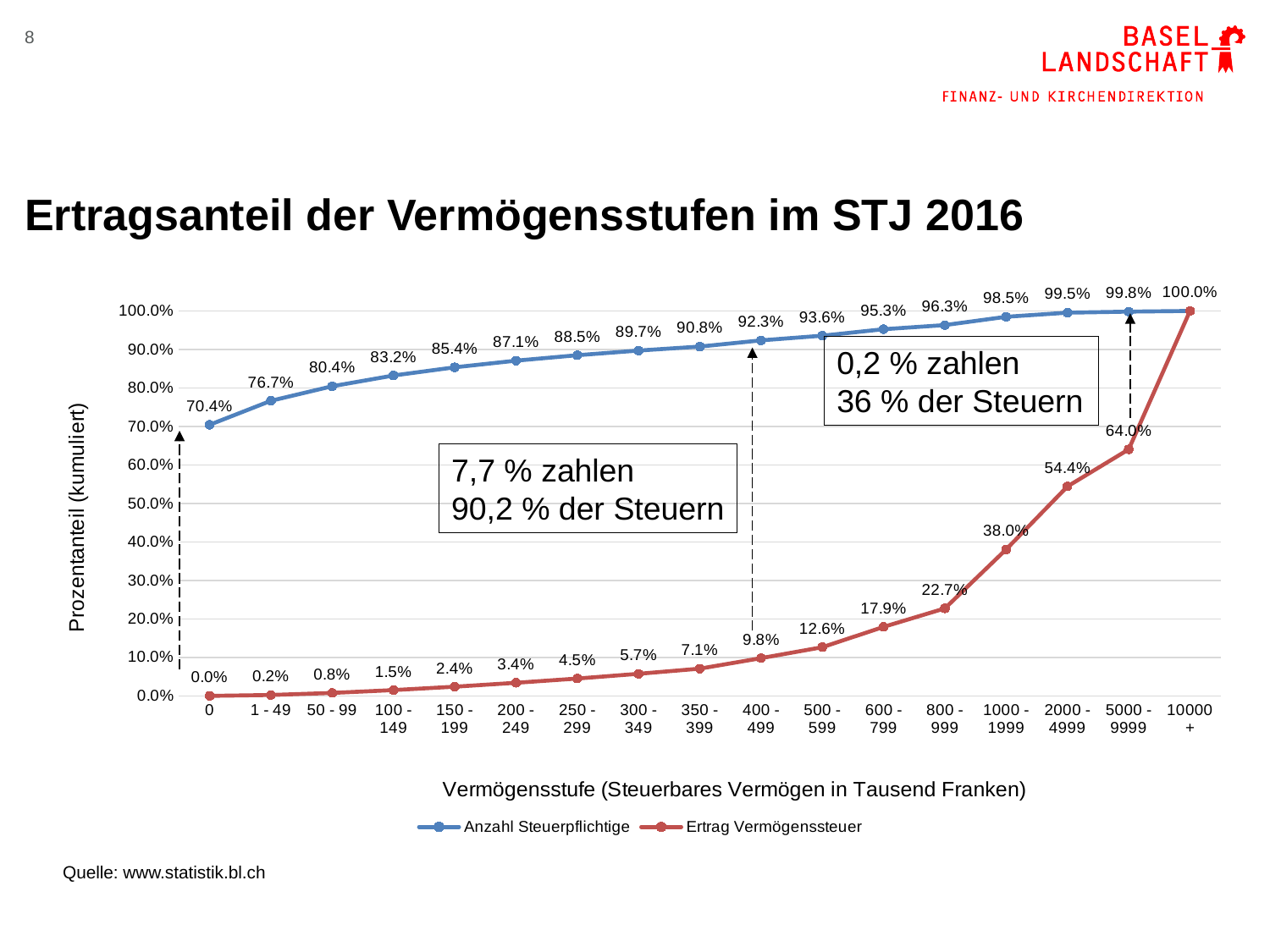
Which category has the lowest value for Ertrag Vermögenssteuer? 0 Do the values of Ertrag Vermögenssteuer rise or fall along the x axis? rise Which is larger for the category 800 - 999: Anzahl Steuerpflichtige or Ertrag Vermögenssteuer? Anzahl Steuerpflichtige What is the title of the chart? Ertragsanteil der Vermögensstufen im STJ 2016 What is the value of Anzahl Steuerpflichtige for the category 0? 70.4% What is the value of Ertrag Vermögenssteuer for the category 5000 - 9999? 64.0% What type of chart is shown on the slide? line chart What is the value of Ertrag Vermögenssteuer for the category 1000 - 1999? 38.0% How many series does the legend list? 2 What is the difference between the Anzahl Steuerpflichtige value and the Ertrag Vermögenssteuer value for the category 2000 - 4999? 45.1% How many categories are shown on the x axis? 17 What is the value of Anzahl Steuerpflichtige for the category 400 - 499? 92.3%